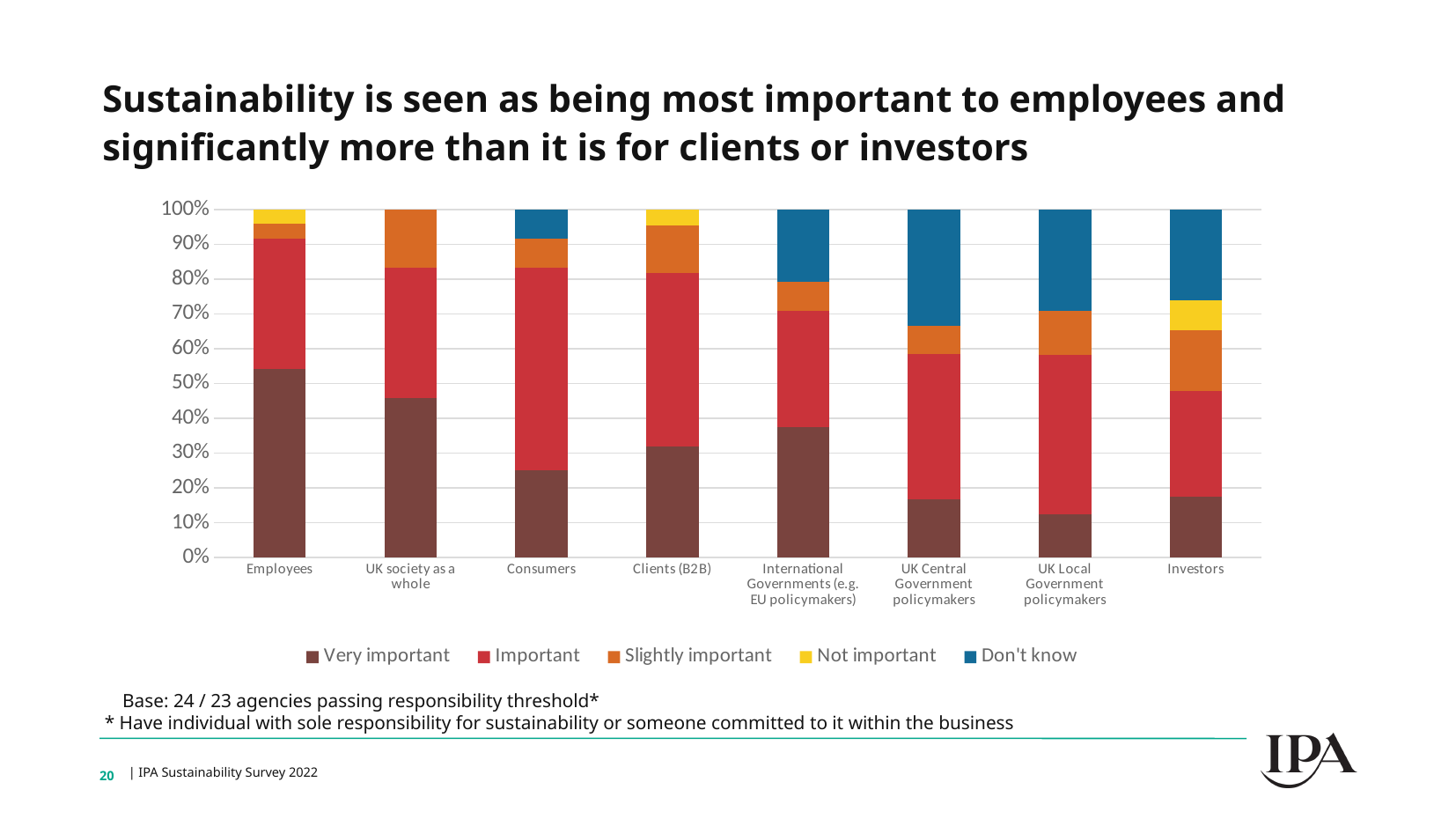
Is the 'Very important' value for UK society as a whole greater or less than 50%? less Is the 'Very important' value for International Governments (e.g. EU policymakers) greater or less than 30%? greater Is the 'Very important' value for Consumers greater or less than 30%? less Which has the larger 'Very important' segment, Employees or UK society as a whole? Employees Which has the larger 'Very important' segment, Consumers or Clients (B2B)? Clients (B2B) What kind of chart is shown on the slide? Stacked bar chart What colour represents the 'Don't know' series in the legend? Blue Which category has the largest 'Very important' segment? Employees Which has the larger 'Don't know' segment, Investors or Consumers? Investors How many categories (stakeholder groups) are shown on the x axis? 8 How many series does the legend list? 5